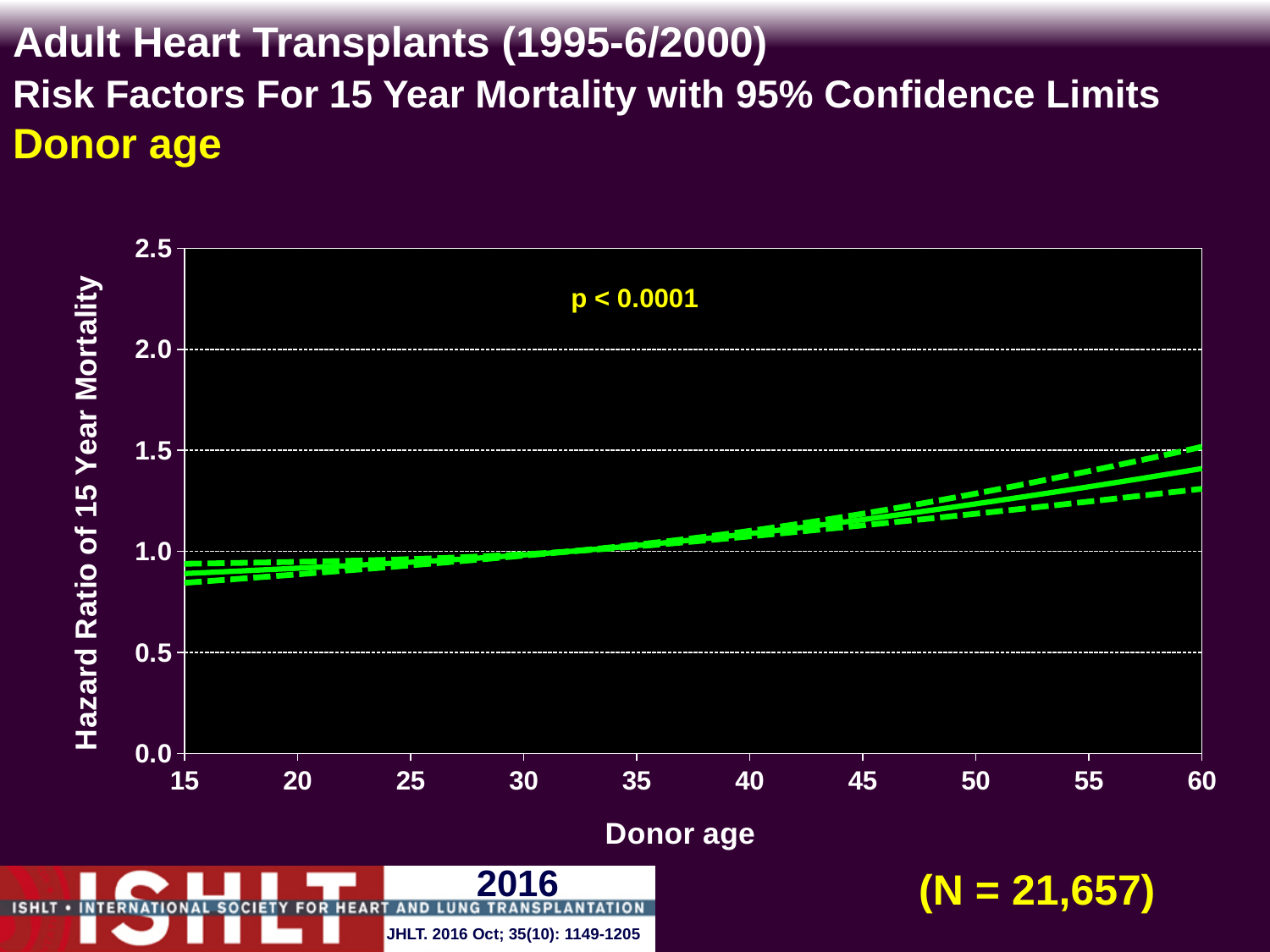
What sample size (N) is shown on the slide? N = 21,657 Is the lower confidence limit at donor age 60 greater or less than 1.5? less How many lines are plotted on the chart (the estimate plus its confidence limits)? 3 What kind of chart is shown on the slide? line chart What p-value is printed on the chart? p < 0.0001 Is the hazard ratio at donor age 60 greater or less than 1.0? greater Is the hazard ratio at donor age 15 greater or less than 0.5? greater Which donor age has the higher hazard ratio, 20 or 55? 55 Does the hazard ratio of 15 year mortality rise or fall as donor age increases from 15 to 60? rise